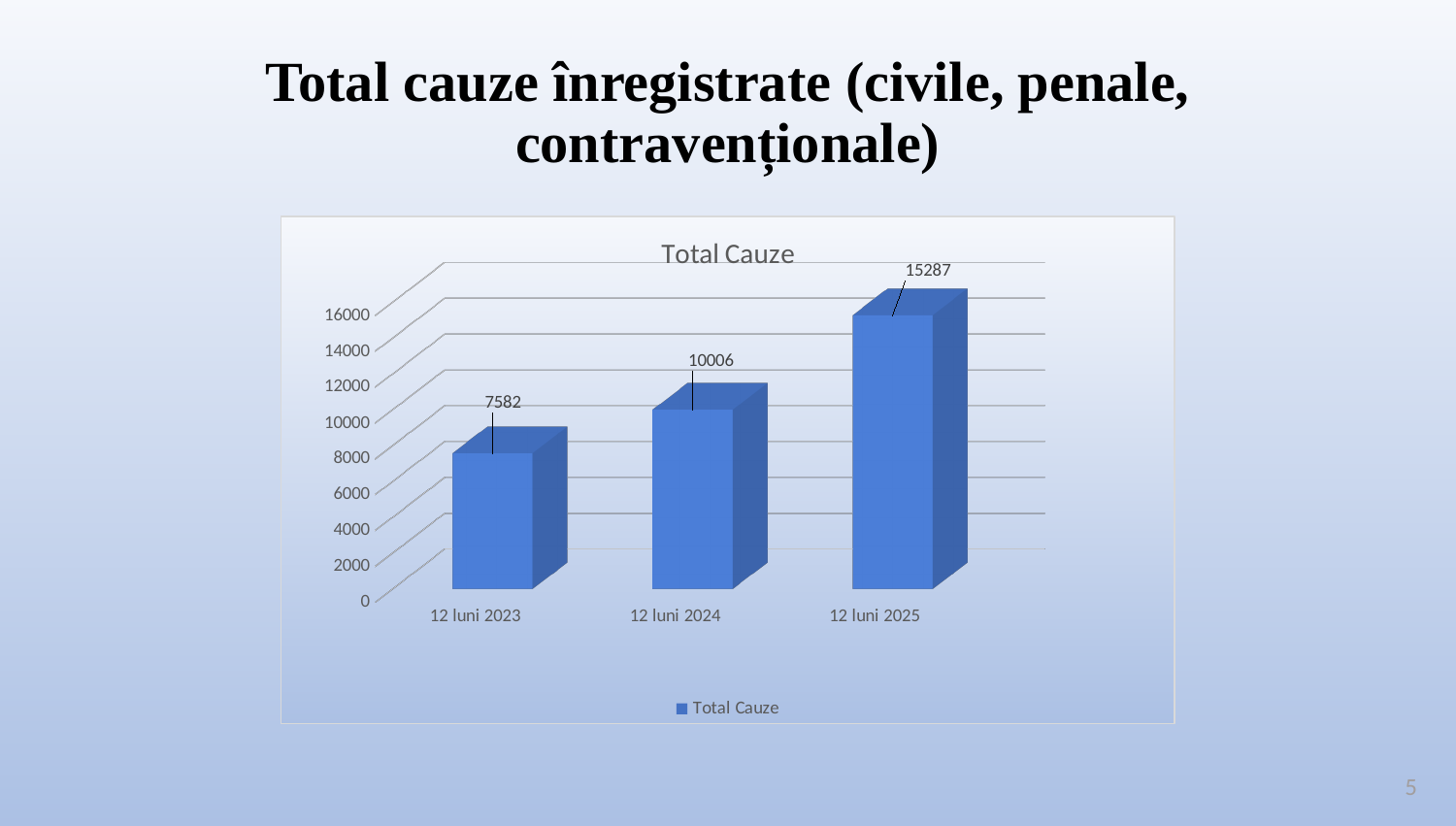
What is the value for 12 luni 2025? 15287 How many series does the legend list? 1 What kind of chart is shown? bar chart Which category has the highest value? 12 luni 2025 Do the values rise or fall from 12 luni 2023 to 12 luni 2025? rise What is the value for 12 luni 2024? 10006 What is the value for 12 luni 2023? 7582 How many categories are shown on the x axis? 3 Which is larger, the value for 12 luni 2023 or the value for 12 luni 2024? 12 luni 2024 What is the difference between the values for 12 luni 2025 and 12 luni 2024? 5281 What is the difference between the values for 12 luni 2024 and 12 luni 2023? 2424 Which category has the lowest value? 12 luni 2023